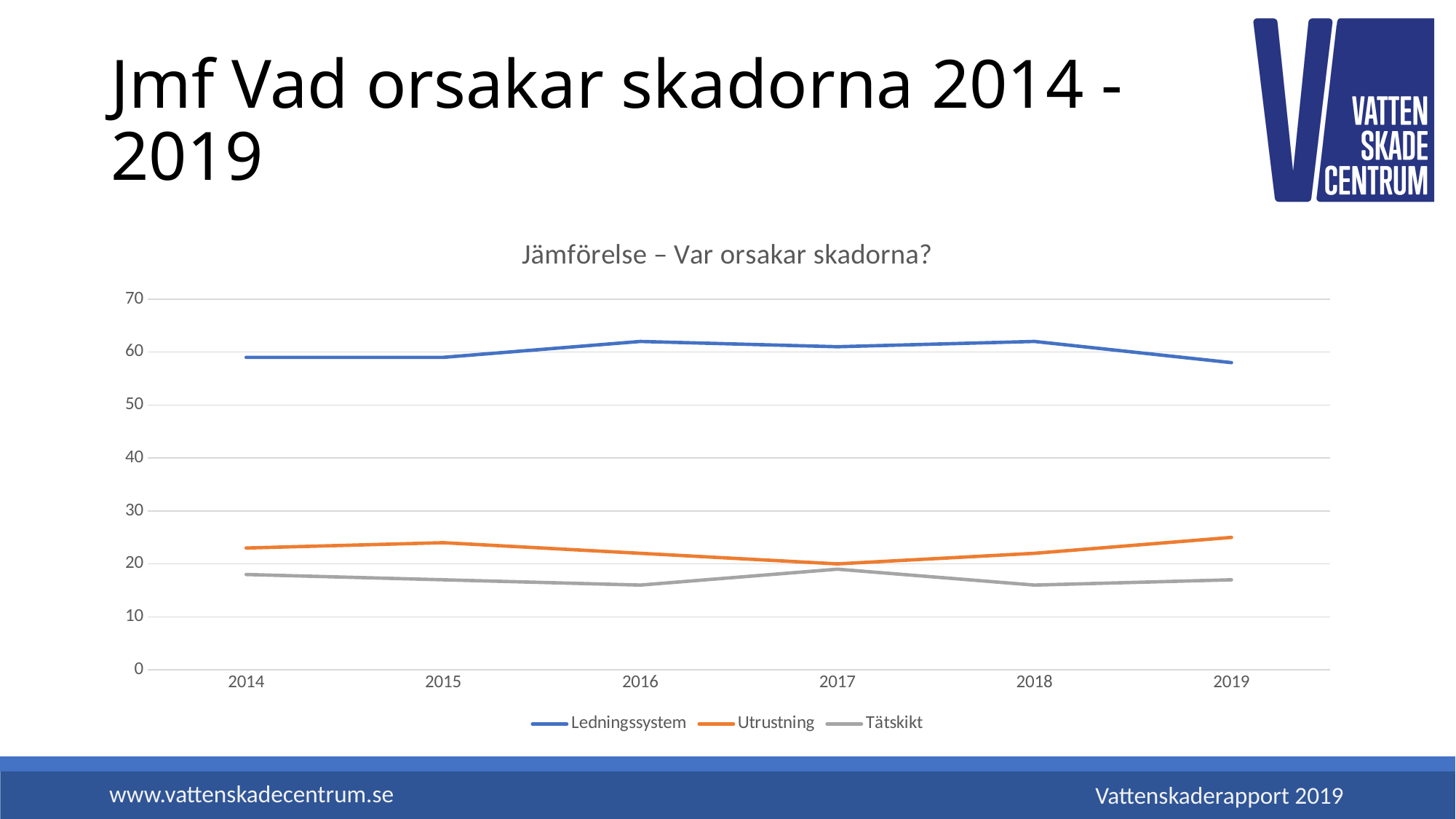
How many series does the legend list? 3 Is the value for Utrustning in 2019 greater or less than 30? less Is the value for Ledningssystem in 2014 greater or less than 50? greater Is the value for Tätskikt in 2016 greater or less than 20? less Does the Ledningssystem series rise or fall from 2018 to 2019? fall Which series has the higher value in 2014, Ledningssystem or Utrustning? Ledningssystem What is the title of the chart? Jämförelse – Var orsakar skadorna? In which year is the Utrustning series at its lowest? 2017 What kind of chart is shown on the slide? line chart Which colour is used for the Utrustning series? orange How many years are shown on the x axis? 6